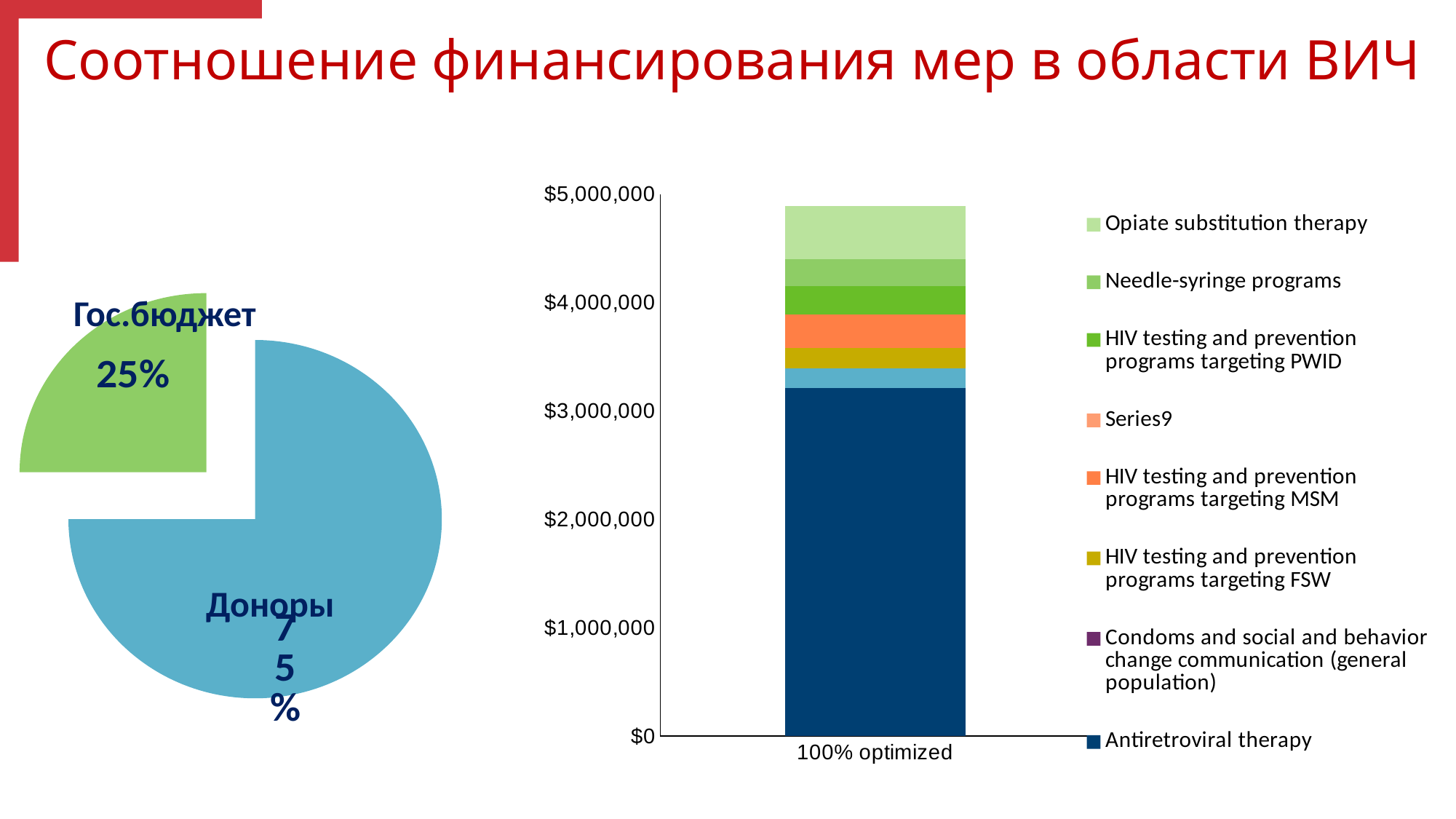
In the bar chart on the right, is the Antiretroviral therapy segment greater or less than $3,000,000? greater In the bar chart on the right, is the total height of the stacked bar greater or less than $5,000,000? less In the pie chart on the left, what is the difference in percentage points between the Доноры share and the Гос.бюджет share? 50% How many categories are shown on the x axis of the bar chart on the right? 1 In the pie chart on the left, what share is labelled for Гос.бюджет? 25% What kind of chart is the chart on the left of the slide? Pie chart In the pie chart on the left, what share is labelled for Доноры? 75% How many series does the legend of the bar chart on the right list? 8 How many slices does the pie chart on the left have? 2 In the pie chart on the left, which slice is the smallest? Гос.бюджет What kind of chart is the chart on the right of the slide? Stacked bar chart In the pie chart on the left, which slice is the largest? Доноры